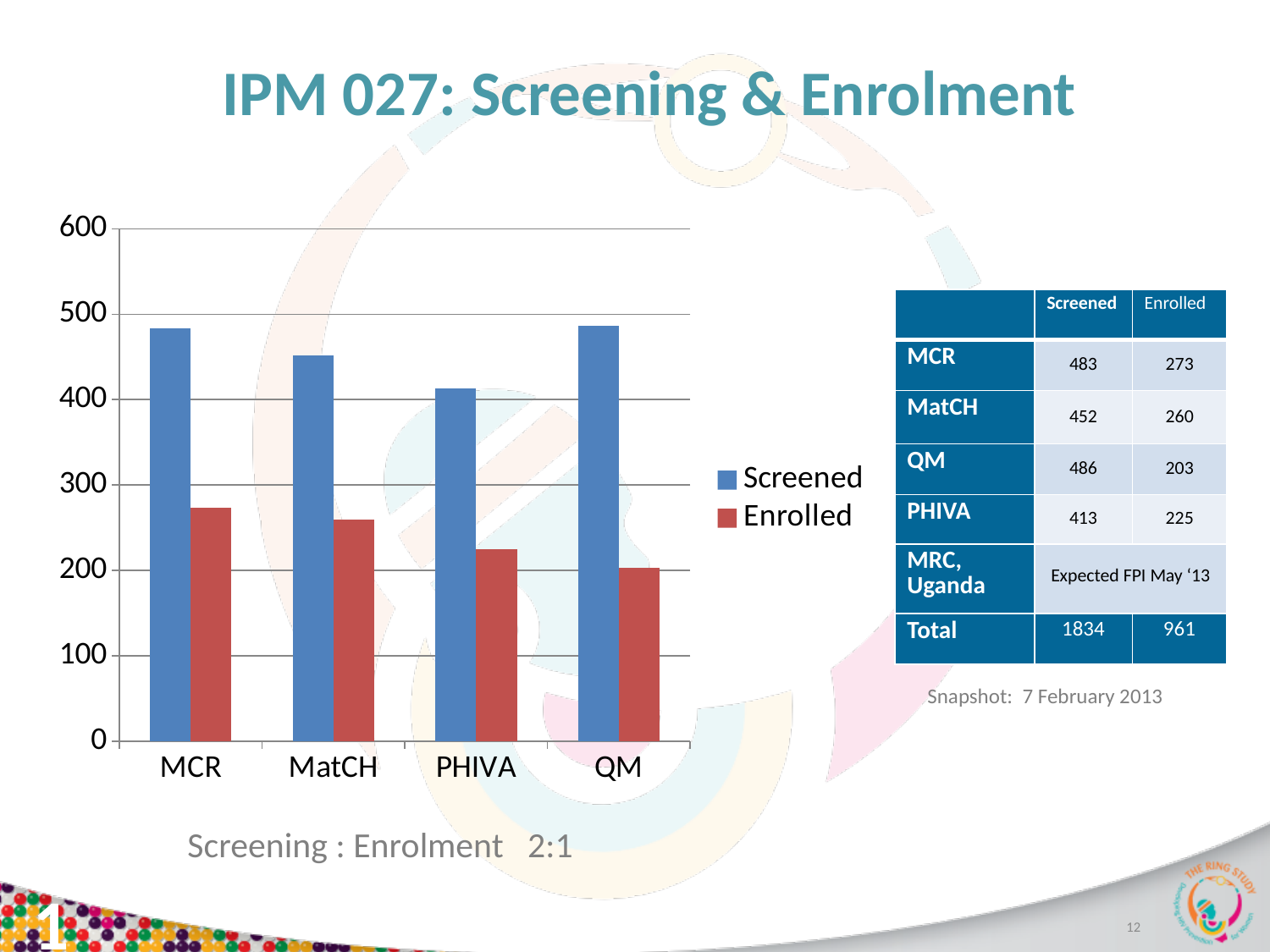
How many series does the chart legend list? 2 Is the Enrolled value for QM greater or less than 300? less Is the Screened value for PHIVA greater or less than 400? greater Which series is shown in blue in the chart? Screened What type of chart is shown on the slide? bar chart Which site has the lowest Enrolled value? QM According to the table on the slide, what is the Screened value for MCR? 483 According to the table on the slide, what is the Enrolled value for PHIVA? 225 Which site has the lowest Screened value? PHIVA How many sites are shown on the x axis of the chart? 4 Is the Screened value for MatCH greater or less than 500? less Which is larger for PHIVA, the Screened value or the Enrolled value? Screened